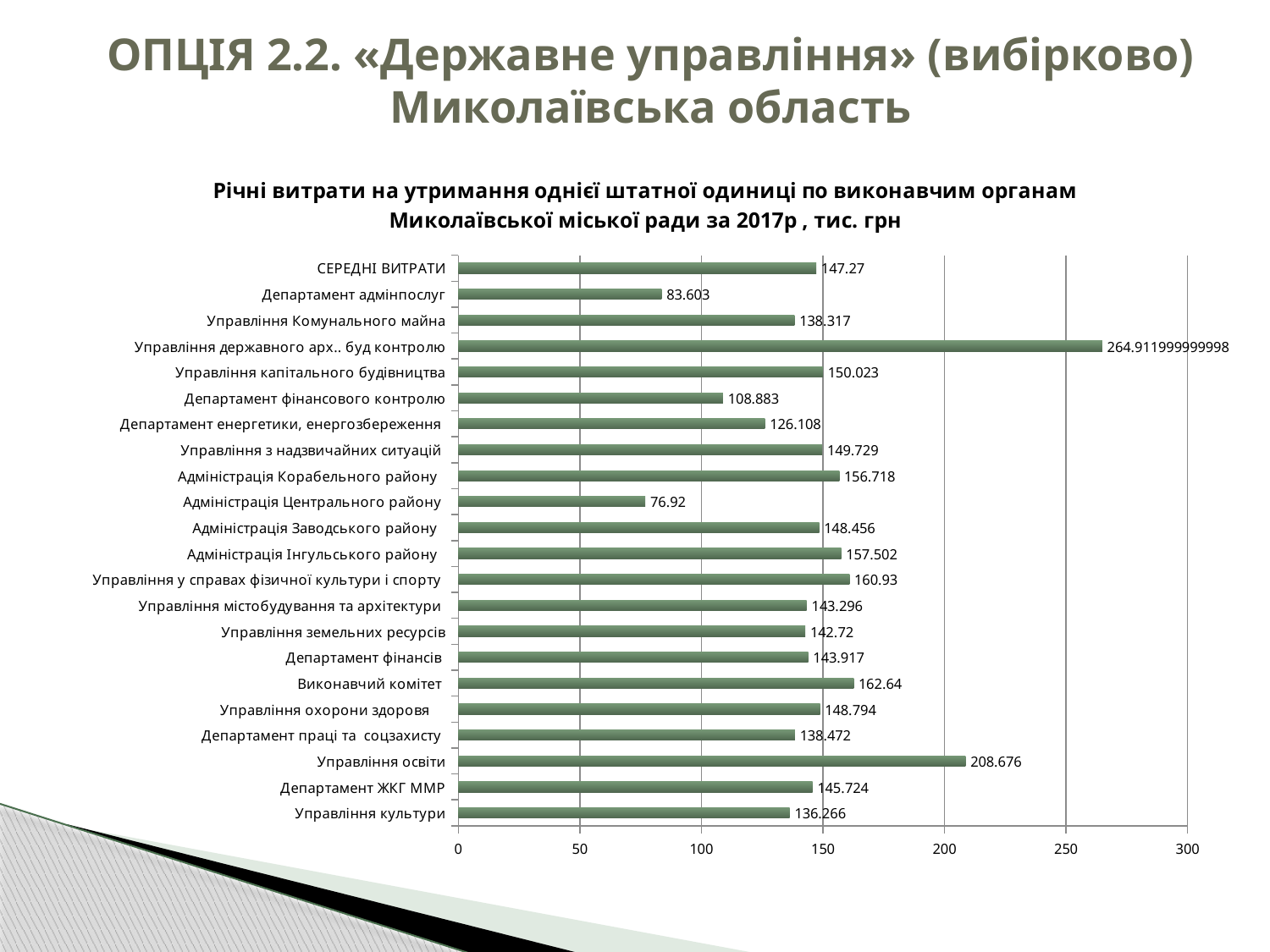
Is the value for Департамент фінансового контролю greater or less than 100? greater What is the title of the chart? Річні витрати на утримання однієї штатної одиниці по виконавчим органам Миколаївської міської ради за 2017р , тис. грн What is the value for СЕРЕДНІ ВИТРАТИ? 147.27 Which category has the lowest value? Адміністрація Центрального району Which is larger, the value for Управління освіти or the value for Виконавчий комітет? Управління освіти What kind of chart is shown on the slide? bar chart What is the value for Управління освіти? 208.676 What is the difference between the values for Управління освіти and Департамент адмінпослуг? 125.073 How many categories are shown in the chart? 22 What is the value for Виконавчий комітет? 162.64 Which category has the highest value? Управління державного арх.. буд контролю What is the value for Департамент адмінпослуг? 83.603